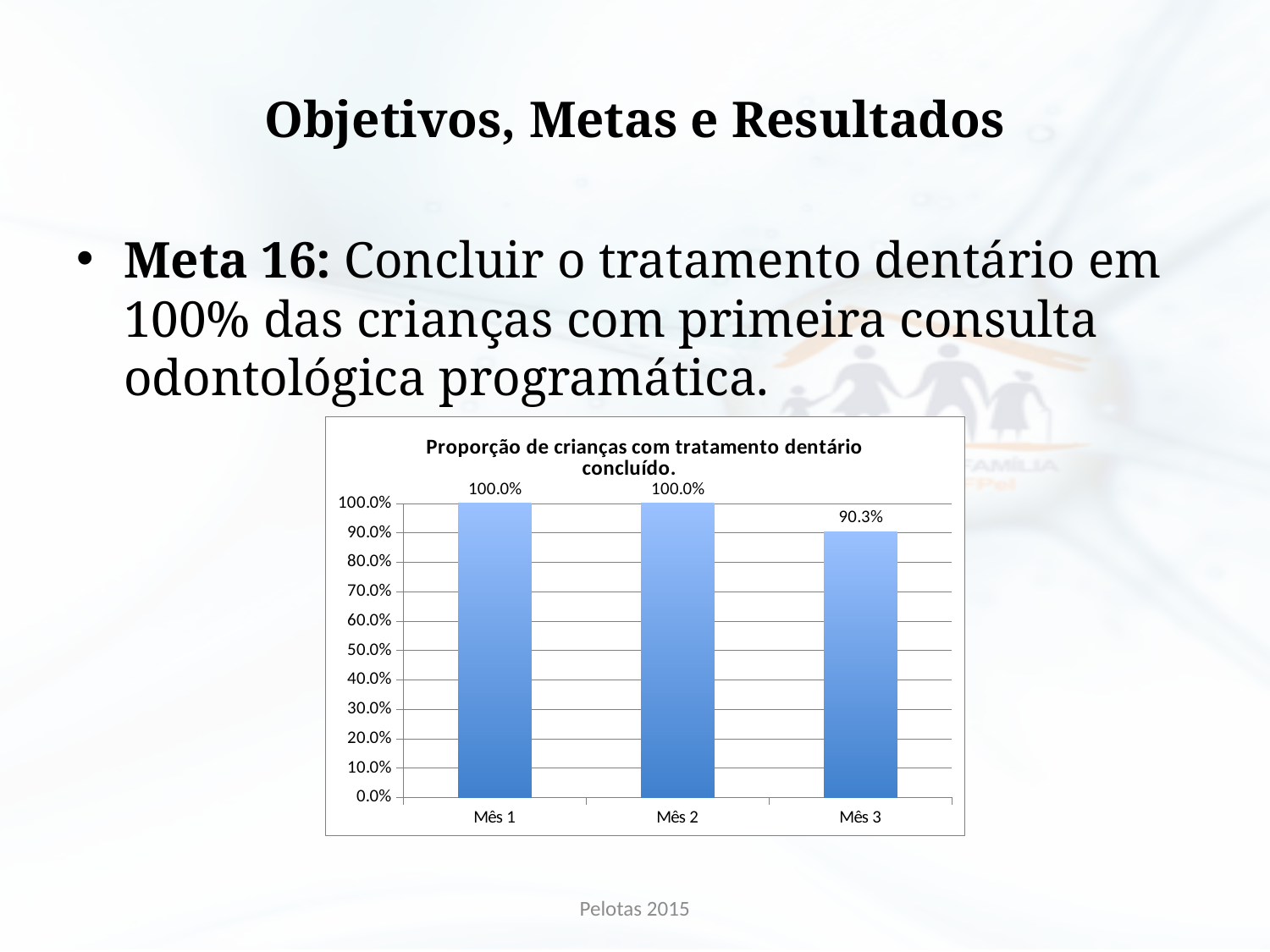
What is the value for Mês 2? 100.0% What is the difference between the values for Mês 2 and Mês 3? 9.7% What is the highest value shown on the y axis? 100.0% Do the values rise or fall from Mês 2 to Mês 3? fall Which is larger, the value for Mês 1 or the value for Mês 3? Mês 1 Which month has the lowest value? Mês 3 How many months are shown on the x axis? 3 What is the value for Mês 1? 100.0% What is the title of the chart? Proporção de crianças com tratamento dentário concluído. What kind of chart is shown on the slide? bar chart What is the value for Mês 3? 90.3% Is the value for Mês 3 greater or less than 80.0%? greater